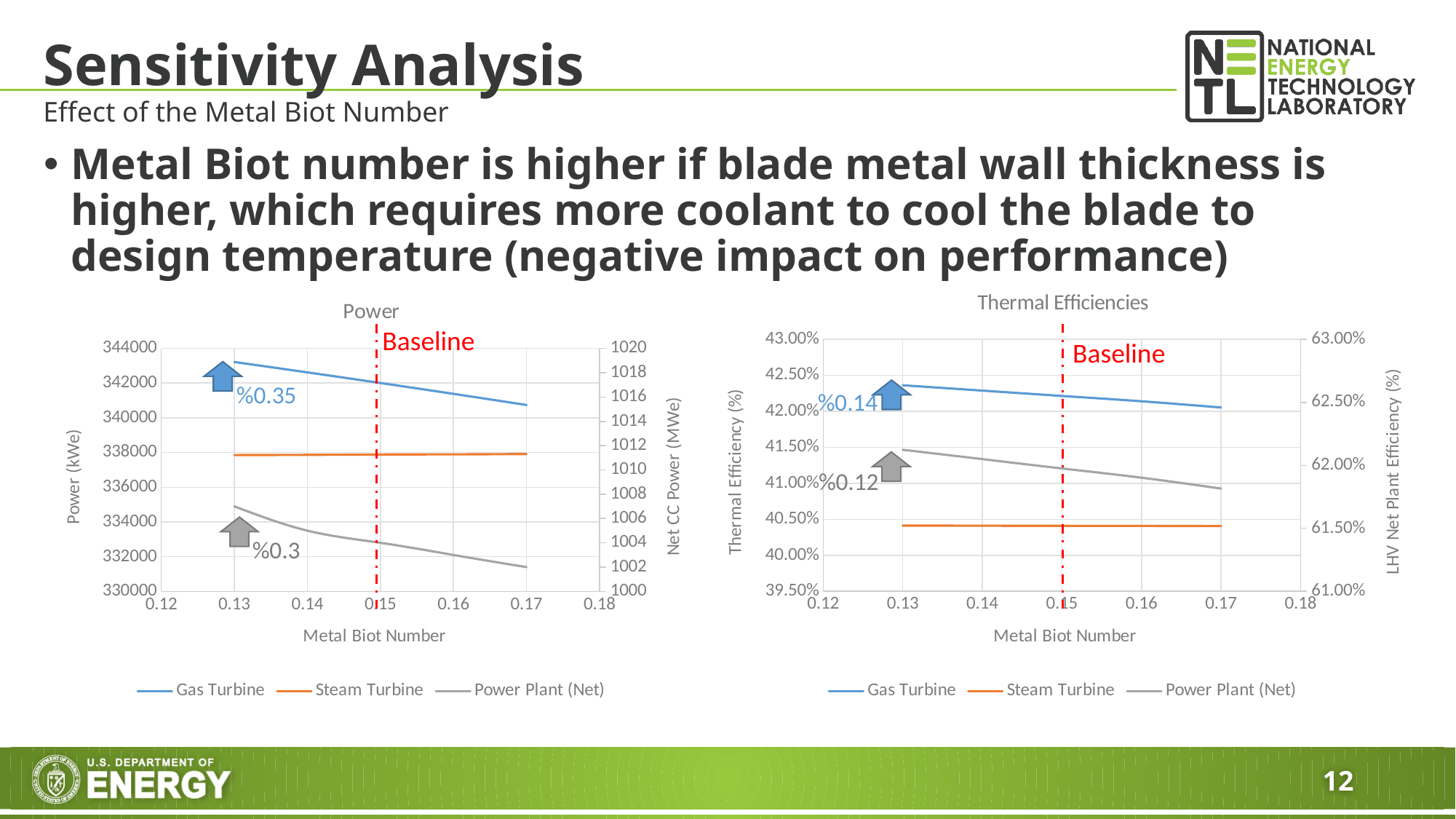
In the Thermal Efficiencies chart, is the Steam Turbine thermal efficiency greater or less than 41.00%? less What is the title of the right-hand chart? Thermal Efficiencies At what Metal Biot Number is the Baseline marked in the Power chart? 0.15 In the Power chart, does the Gas Turbine power rise or fall as the Metal Biot Number increases? fall In the Thermal Efficiencies chart, does the Power Plant (Net) efficiency rise or fall as the Metal Biot Number increases? fall In the Power chart, is the Steam Turbine power greater or less than 336000? greater In the Power chart, is the Gas Turbine power at a Metal Biot Number of 0.13 greater or less than 342000? greater In the Power chart, which series has the higher power on the left axis, Gas Turbine or Steam Turbine? Gas Turbine How many series does the legend of the Thermal Efficiencies chart list? 3 What kind of chart is the Power chart? line chart